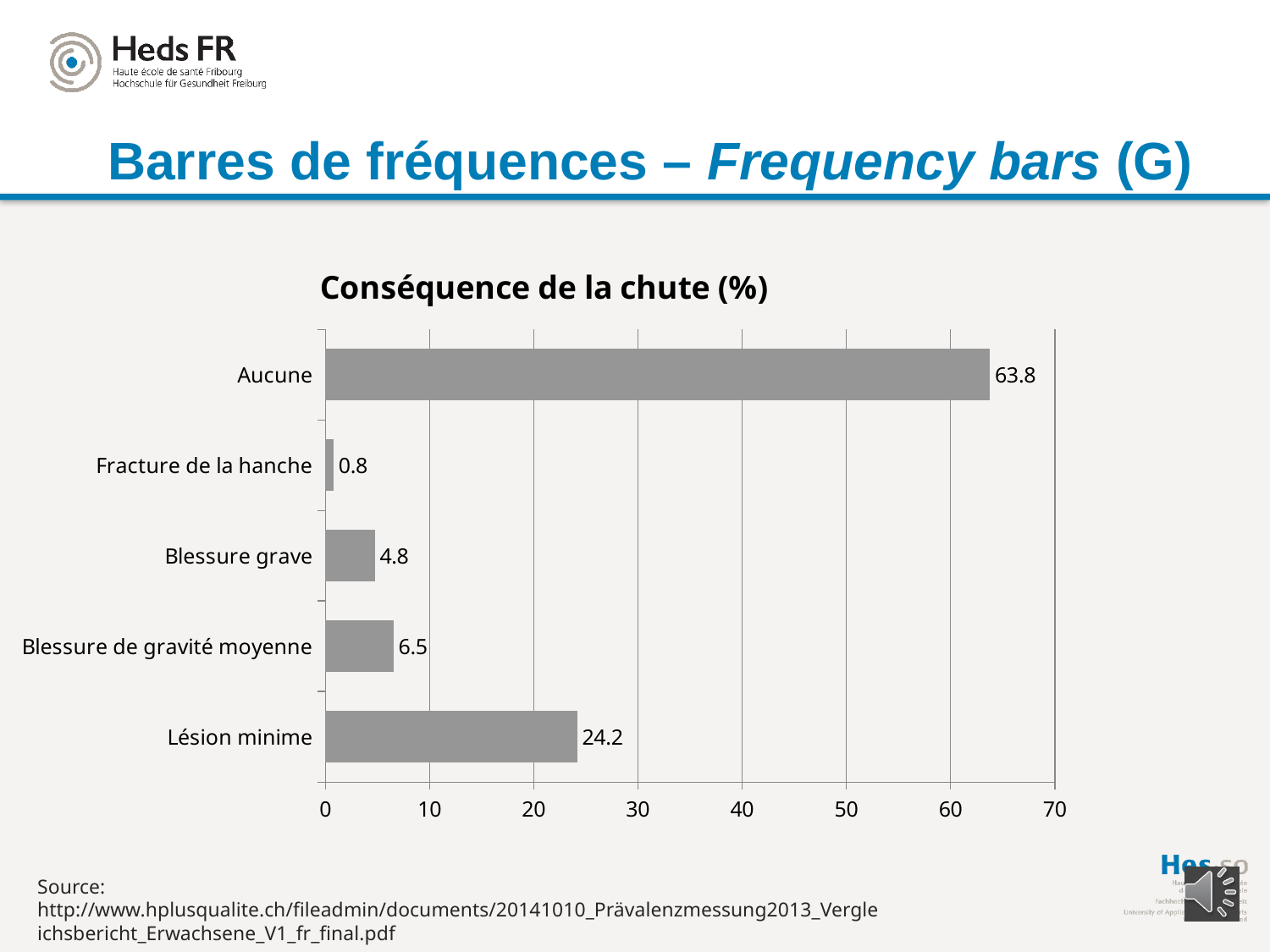
What kind of chart is shown on the slide? bar chart What is the difference between the values for Aucune and Lésion minime? 39.6 What is the value for Lésion minime? 24.2 What is the title of the chart? Conséquence de la chute (%) Which category has the highest value? Aucune Which category has the lowest value? Fracture de la hanche What is the difference between the values for Blessure de gravité moyenne and Blessure grave? 1.7 What is the value for Aucune? 63.8 How many categories are shown in the chart? 5 Which is larger, the value for Blessure grave or the value for Blessure de gravité moyenne? Blessure de gravité moyenne Is the value for Lésion minime greater or less than 20? greater What is the value for Fracture de la hanche? 0.8